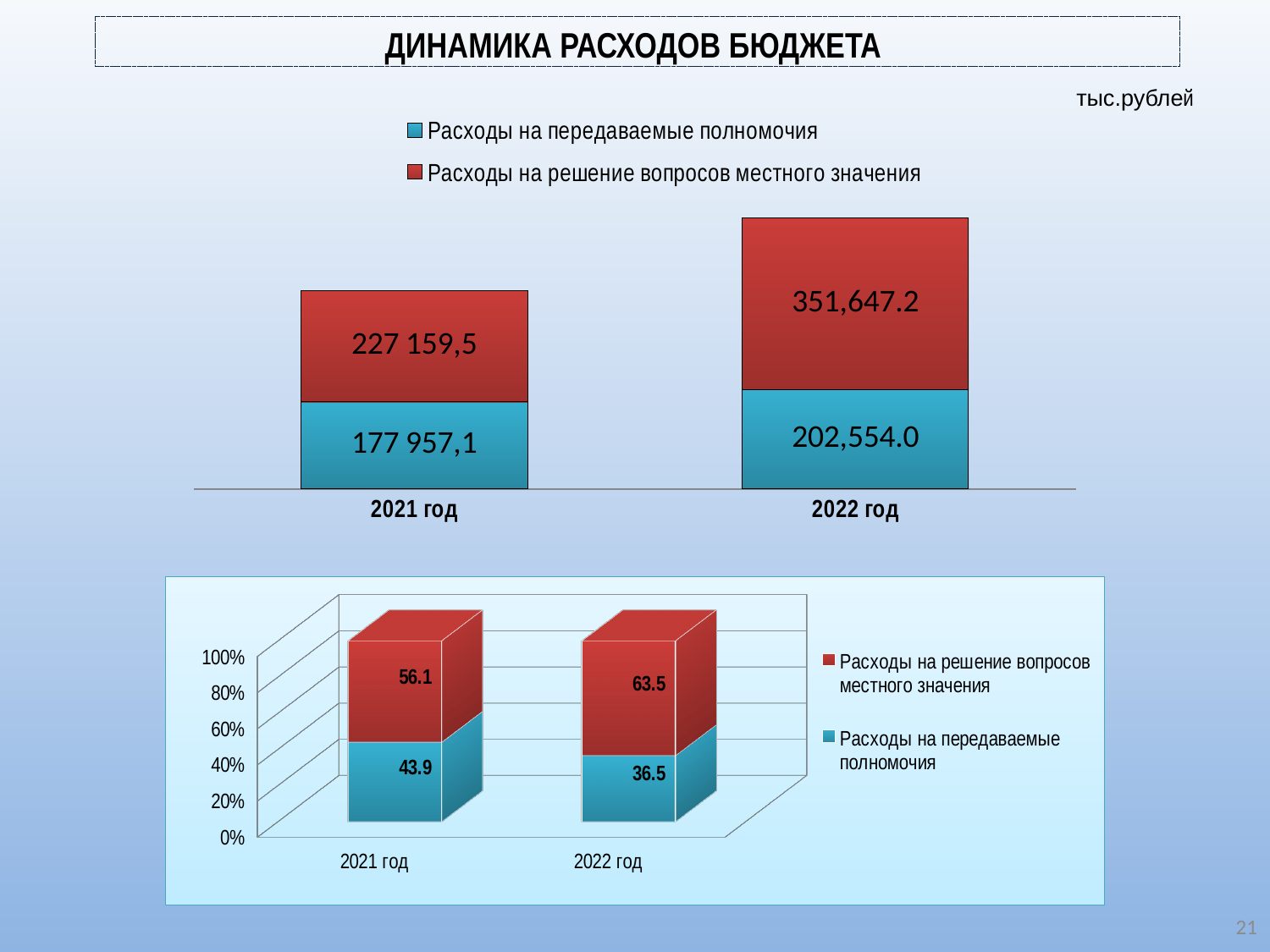
In the top chart, what is the value of Расходы на решение вопросов местного значения for 2022 год? 351,647.2 In the top chart, what is the value of Расходы на решение вопросов местного значения for 2021 год? 227 159,5 How many series does the legend of the bottom chart list? 2 In the top chart, which year has the larger value for Расходы на решение вопросов местного значения, 2021 год or 2022 год? 2022 год In the top chart, what is the value of Расходы на передаваемые полномочия for 2021 год? 177 957,1 In the top chart, what is the difference between Расходы на решение вопросов местного значения and Расходы на передаваемые полномочия for 2022 год? 149,093.2 In the bottom chart, what is the percentage for Расходы на передаваемые полномочия in 2022 год? 36.5 In the bottom chart, what is the difference between the two series' percentages for 2022 год? 27.0 In the bottom chart, what is the percentage for Расходы на решение вопросов местного значения in 2021 год? 56.1 In the top chart, what is the total of the stacked bar for 2022 год? 554,201.2 In the top chart, what is the value of Расходы на передаваемые полномочия for 2022 год? 202,554.0 What type of chart is the top chart? Stacked bar chart